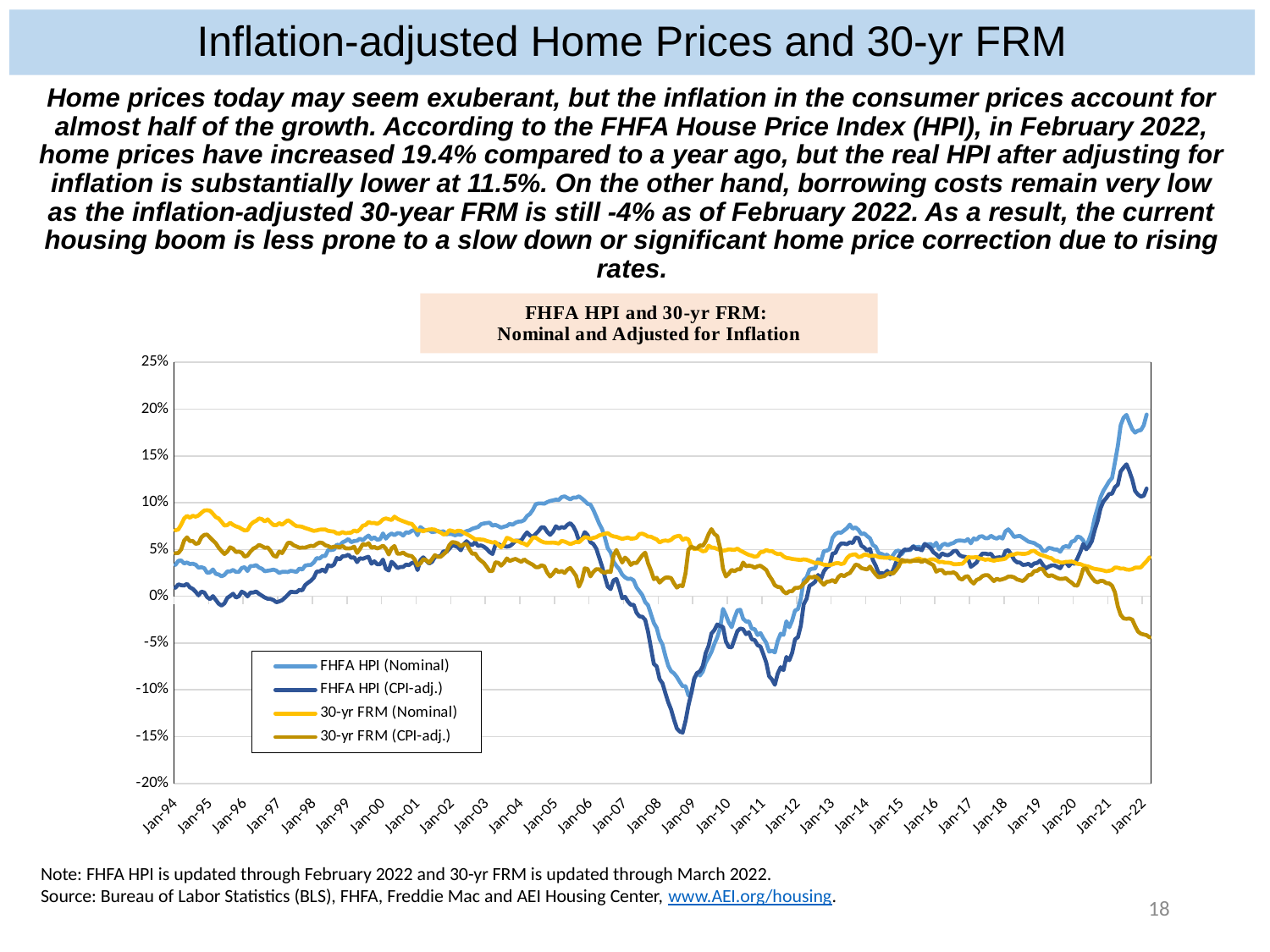
Is the value of 30-yr FRM (CPI-adj.) at Jan-22 greater or less than 0%? less How many year labels are shown on the x axis? 29 Is the value of 30-yr FRM (Nominal) at Jan-95 greater or less than 5%? greater How many series does the chart legend list? 4 Is the lowest value of FHFA HPI (CPI-adj.) around Jan-09 greater or less than -10%? less Does the 30-yr FRM (Nominal) series overall rise or fall from Jan-94 to Jan-22? fall At Jan-22, which is larger: FHFA HPI (Nominal) or FHFA HPI (CPI-adj.)? FHFA HPI (Nominal) What kind of chart is shown on the slide? line chart Which series reaches the lowest value anywhere on the chart? FHFA HPI (CPI-adj.) What is the title of the chart? FHFA HPI and 30-yr FRM: Nominal and Adjusted for Inflation Which series reaches the highest value anywhere on the chart? FHFA HPI (Nominal)